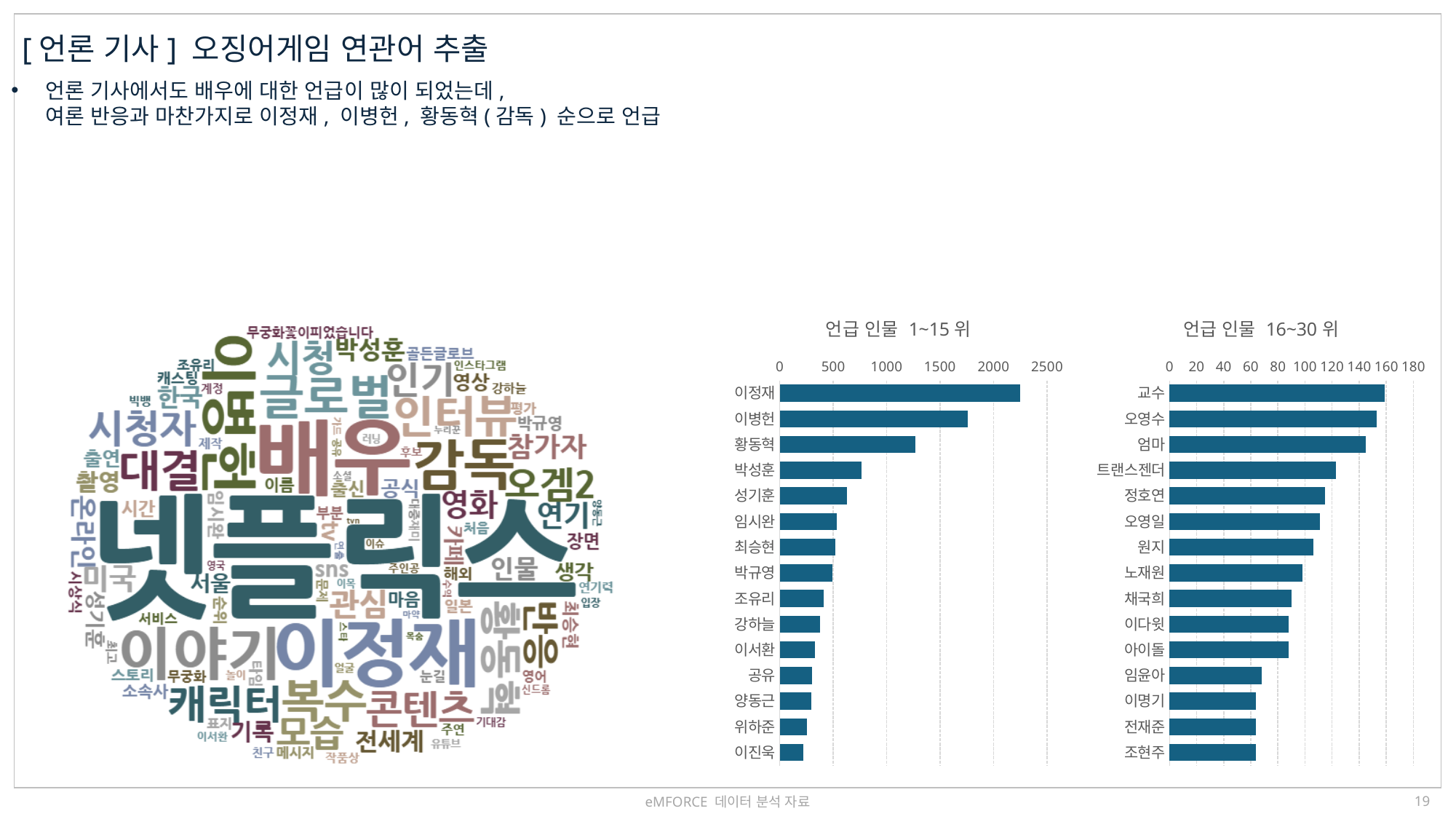
In the chart titled 언급 인물 16~30 위, which is larger, the value for 정호연 or the value for 노재원? 정호연 In the chart titled 언급 인물 16~30 위, is the value for 임윤아 greater or less than 80? less In the chart titled 언급 인물 16~30 위, how many people are listed? 15 In the chart titled 언급 인물 1~15 위, what kind of chart is shown? bar chart In the chart titled 언급 인물 1~15 위, is the value for 이정재 greater or less than 2000? greater In the chart titled 언급 인물 1~15 위, which person has the lowest value? 이진욱 In the chart titled 언급 인물 1~15 위, which person has the highest value? 이정재 In the chart titled 언급 인물 16~30 위, which person has the highest value? 교수 In the chart titled 언급 인물 1~15 위, is the value for 박성훈 greater or less than 1000? less In the chart titled 언급 인물 1~15 위, which is larger, the value for 이병헌 or the value for 황동혁? 이병헌 In the chart titled 언급 인물 1~15 위, how many people are listed? 15